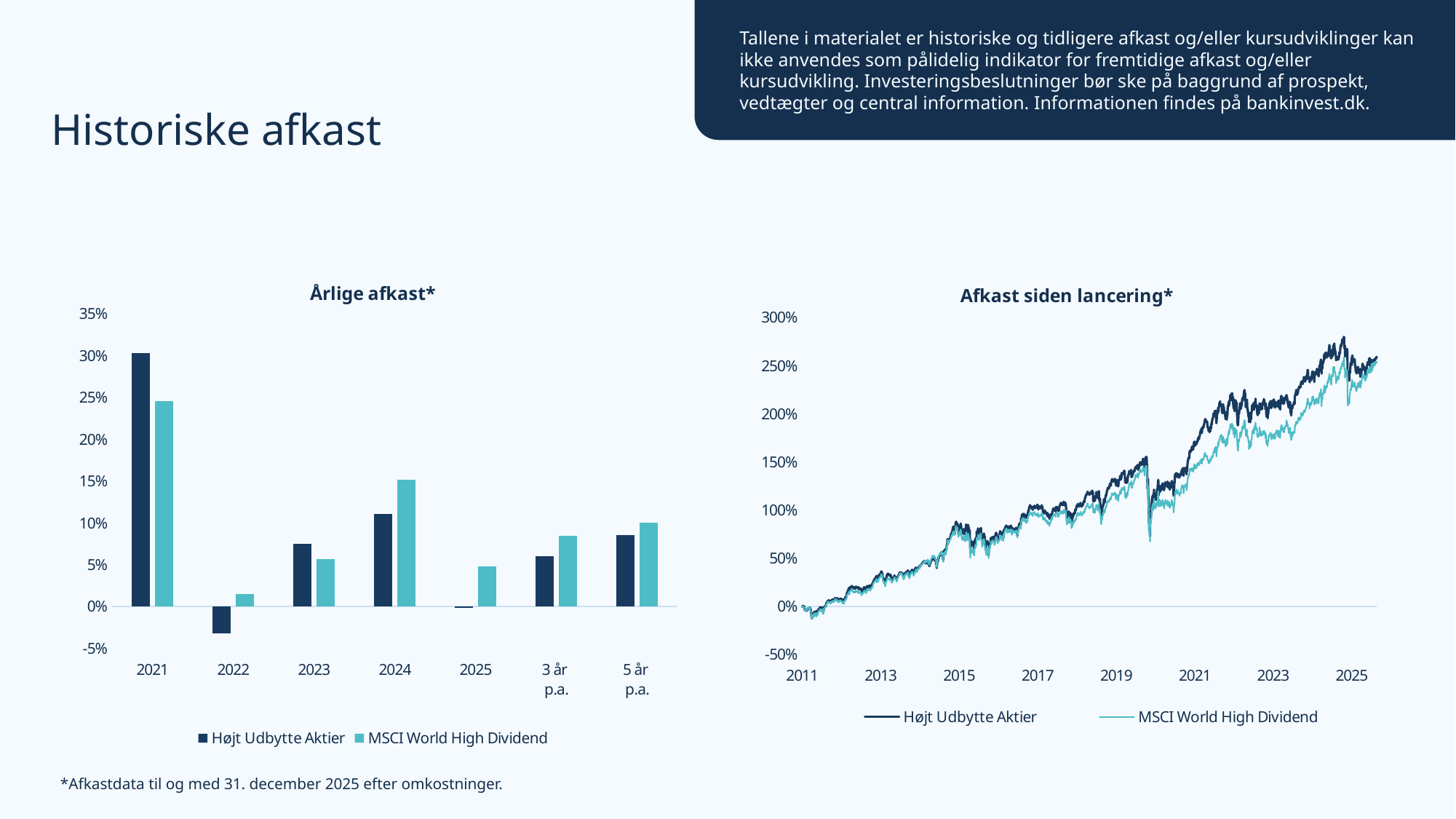
In the "Årlige afkast*" chart, which year has the highest value for Højt Udbytte Aktier? 2021 In the "Årlige afkast*" chart, is the value for MSCI World High Dividend in 2024 greater or less than 10%? greater In the "Årlige afkast*" chart, which series has the larger value in 2021, Højt Udbytte Aktier or MSCI World High Dividend? Højt Udbytte Aktier In the "Årlige afkast*" chart, is the value for Højt Udbytte Aktier in 2021 greater or less than 25%? greater In the "Afkast siden lancering*" chart, is the value for Højt Udbytte Aktier at the end of 2025 greater or less than 200%? greater In the "Årlige afkast*" chart, which category has the lowest value for Højt Udbytte Aktier? 2022 In the "Årlige afkast*" chart, which series has the larger value in 2024, Højt Udbytte Aktier or MSCI World High Dividend? MSCI World High Dividend What kind of chart is the "Afkast siden lancering*" chart? line chart In the "Årlige afkast*" chart, how many series does the legend list? 2 In the "Afkast siden lancering*" chart, do the values generally rise or fall from 2011 to 2025? rise What kind of chart is the "Årlige afkast*" chart? bar chart In the "Årlige afkast*" chart, how many categories are shown on the x axis? 7